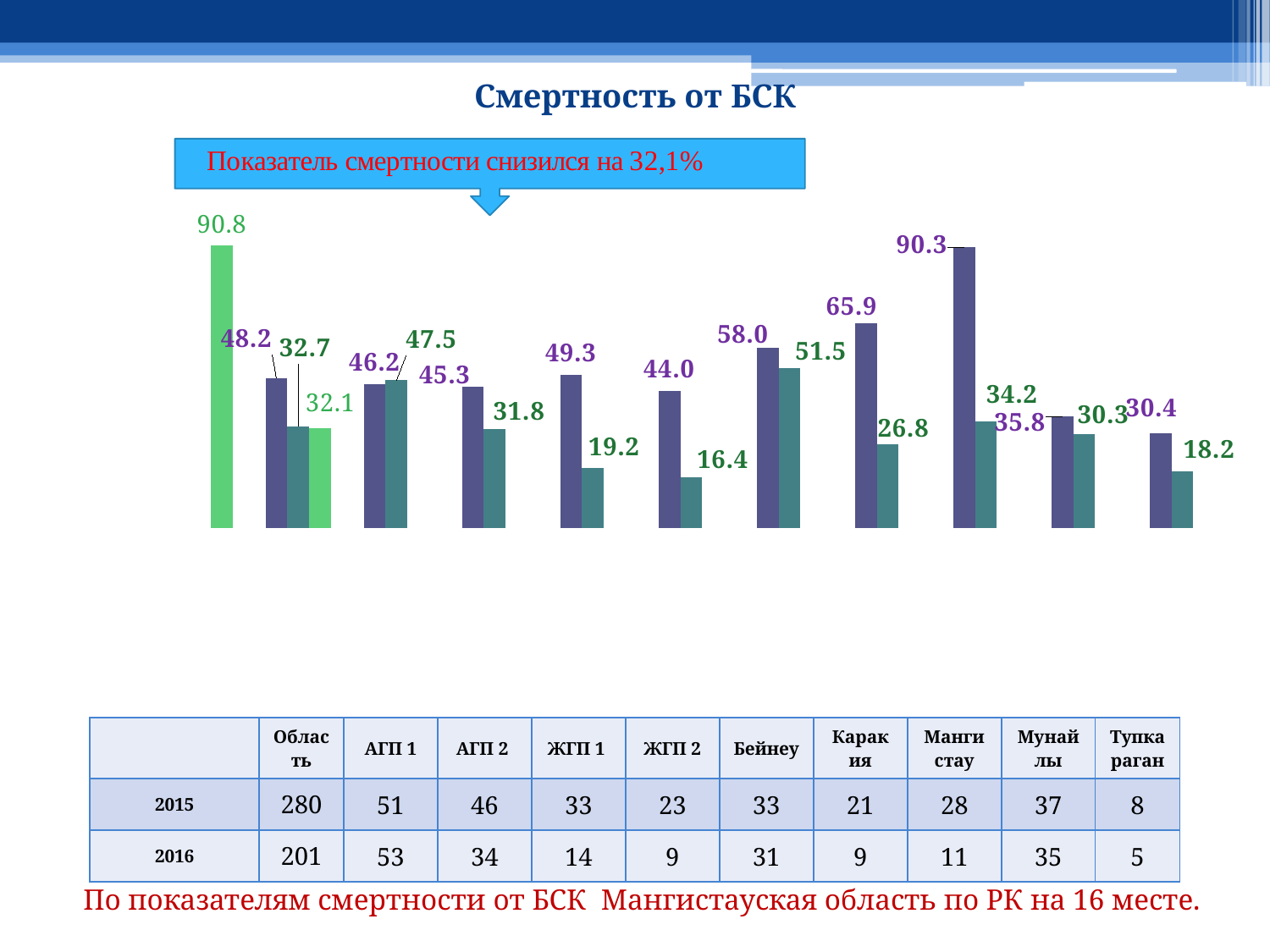
What is the difference between the two green bars on the chart (90.8 and 32.1)? 58.7 How many purple bars are there on the chart? 10 What does the blue callout box above the chart say? Показатель смертности снизился на 32,1% What is the title of the slide containing the chart? Смертность от БСК Which is larger: the tallest green bar or the tallest purple bar? the tallest green bar (90.8) What is the value of the lowest purple bar on the chart? 30.4 In the last group of bars on the right, what is the difference between the purple bar (30.4) and the teal bar (18.2)? 12.2 What kind of chart is shown on the slide? bar chart What is the value of the tallest teal bar on the chart? 51.5 What is the lowest value labeled on the chart? 16.4 What is the highest value labeled on the chart? 90.8 What is the value of the tallest purple bar on the chart? 90.3